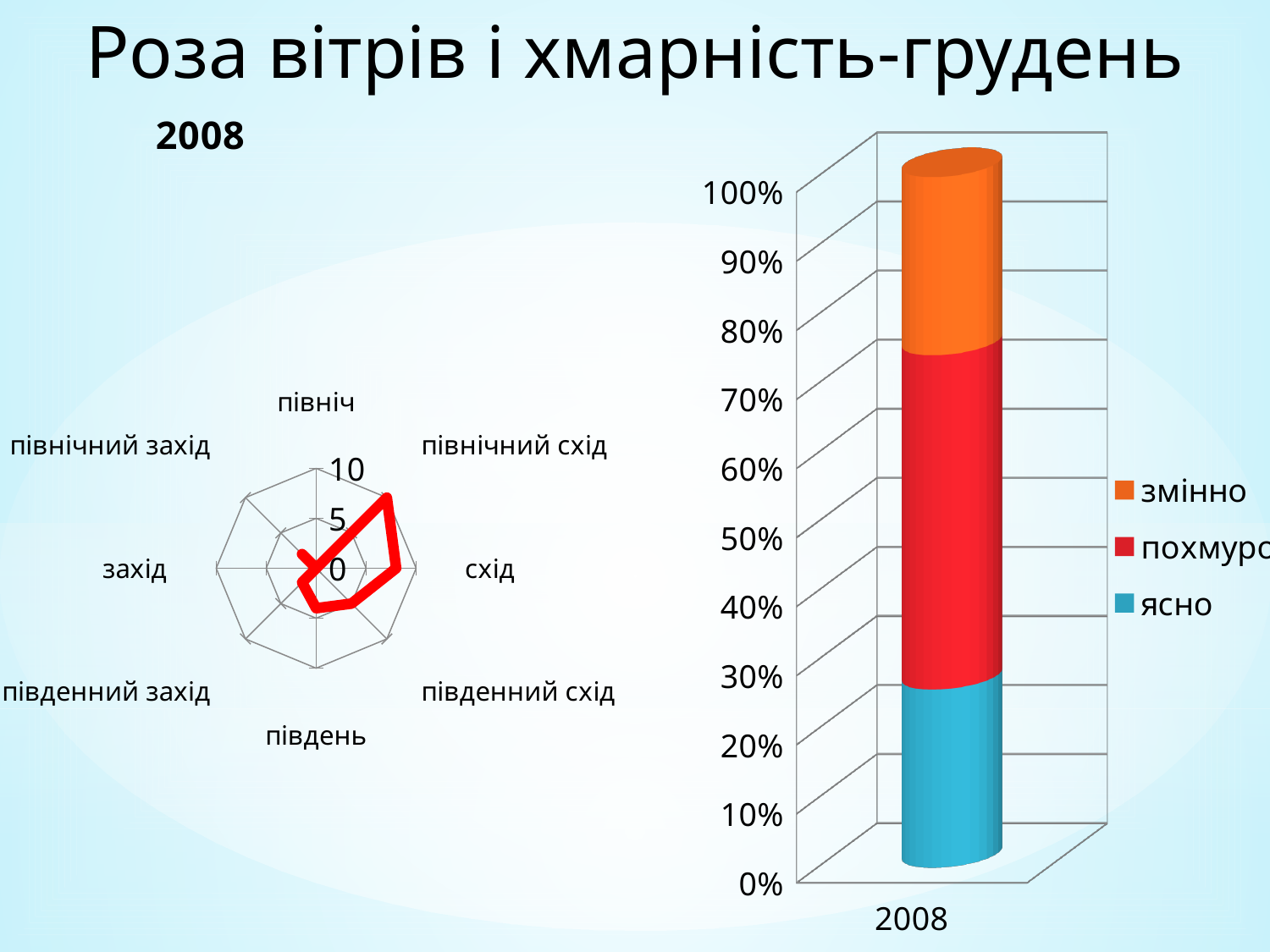
How many categories are shown on the x axis of the right-hand bar chart? 1 What kind of chart is the chart on the left side of the slide? radar chart In the right-hand bar chart, is the value for похмуро greater or less than 40%? greater In the right-hand bar chart, is the value for змінно greater or less than 40%? less In the right-hand bar chart, which series takes up the largest part of the 2008 bar? похмуро In the left-hand radar chart, which direction has the highest value? північний схід How many directions (categories) does the left-hand radar chart show? 8 What kind of chart is the chart on the right side of the slide? bar chart How many series does the legend of the right-hand bar chart list? 3 In the right-hand bar chart, is the value for ясно greater or less than 20%? greater What are the legend entries of the right-hand bar chart? змінно, похмуро, ясно